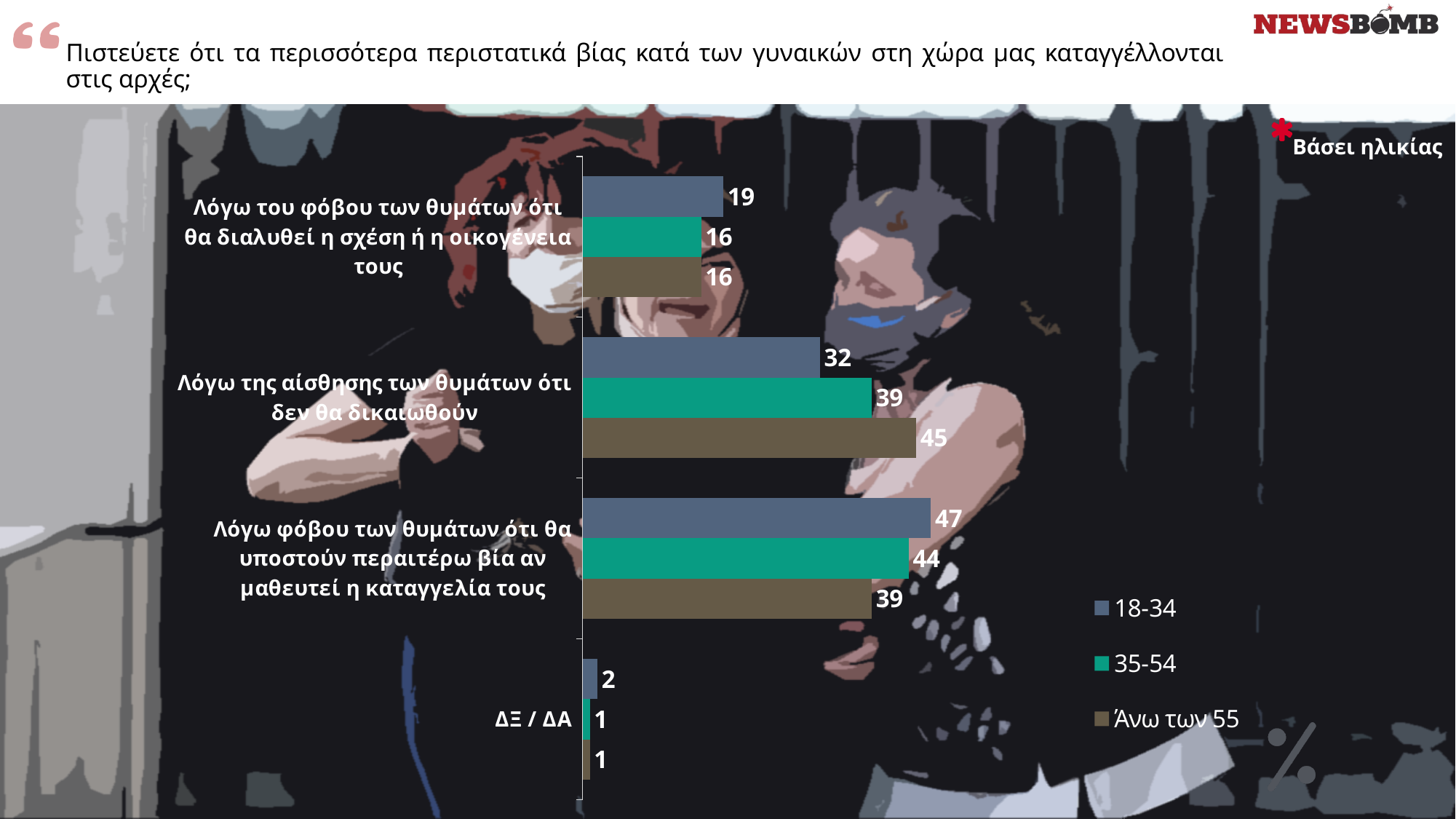
What is the value for the Άνω των 55 series for the category "Λόγω φόβου των θυμάτων ότι θα υποστούν περαιτέρω βία αν μαθευτεί η καταγγελία τους"? 39 Which category has the lowest value for the 35-54 series? ΔΞ / ΔΑ For "Λόγω φόβου των θυμάτων ότι θα υποστούν περαιτέρω βία αν μαθευτεί η καταγγελία τους", which series has the larger value: 18-34 or Άνω των 55? 18-34 What is the value for the 35-54 series for the category "Λόγω του φόβου των θυμάτων ότι θα διαλυθεί η σχέση ή η οικογένεια τους"? 16 Which category has the highest value for the 18-34 series? Λόγω φόβου των θυμάτων ότι θα υποστούν περαιτέρω βία αν μαθευτεί η καταγγελία τους What kind of chart is shown on the slide? Bar chart How many series does the legend list? 3 Which legend entry is shown in green? 35-54 Which category has the highest value for the Άνω των 55 series? Λόγω της αίσθησης των θυμάτων ότι δεν θα δικαιωθούν What is the difference between the Άνω των 55 value and the 18-34 value for "Λόγω της αίσθησης των θυμάτων ότι δεν θα δικαιωθούν"? 13 How many categories are shown in the chart? 4 What is the value for the 18-34 series for the category "Λόγω της αίσθησης των θυμάτων ότι δεν θα δικαιωθούν"? 32